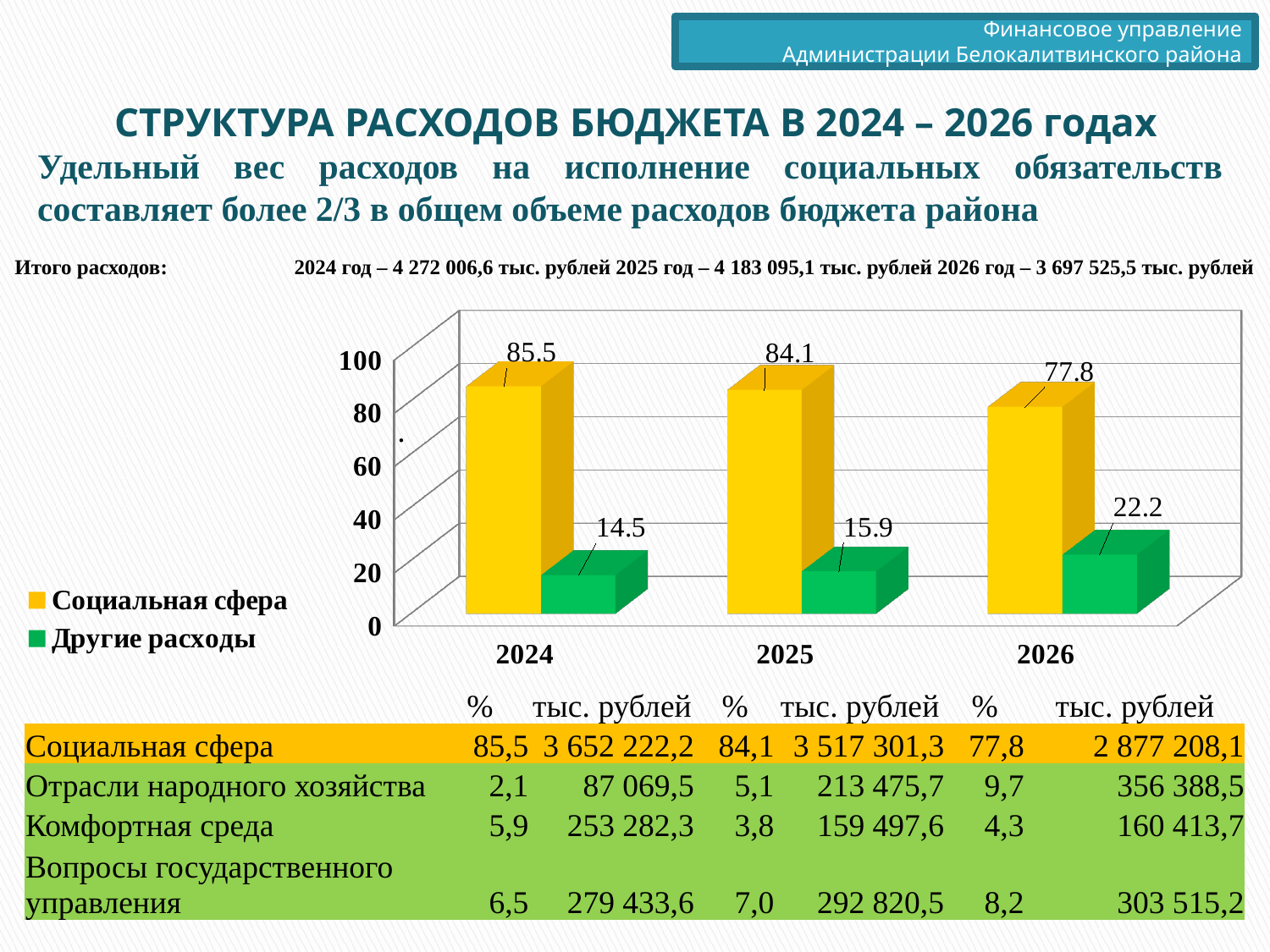
How many series does the chart legend list? 2 What is the value for Другие расходы in 2025? 15.9 How many years are shown on the x axis of the chart? 3 In which year is the value for Другие расходы the highest? 2026 Which is larger in 2025: Социальная сфера or Другие расходы? Социальная сфера What is the value for Социальная сфера in 2024? 85.5 What is the difference between the Социальная сфера values for 2024 and 2026? 7.7 In which year is the value for Социальная сфера the lowest? 2026 What is the value for Другие расходы in 2026? 22.2 What kind of chart is shown on the slide? Bar chart Does the value for Социальная сфера rise or fall from 2024 to 2026? Fall What is the value for Социальная сфера in 2026? 77.8